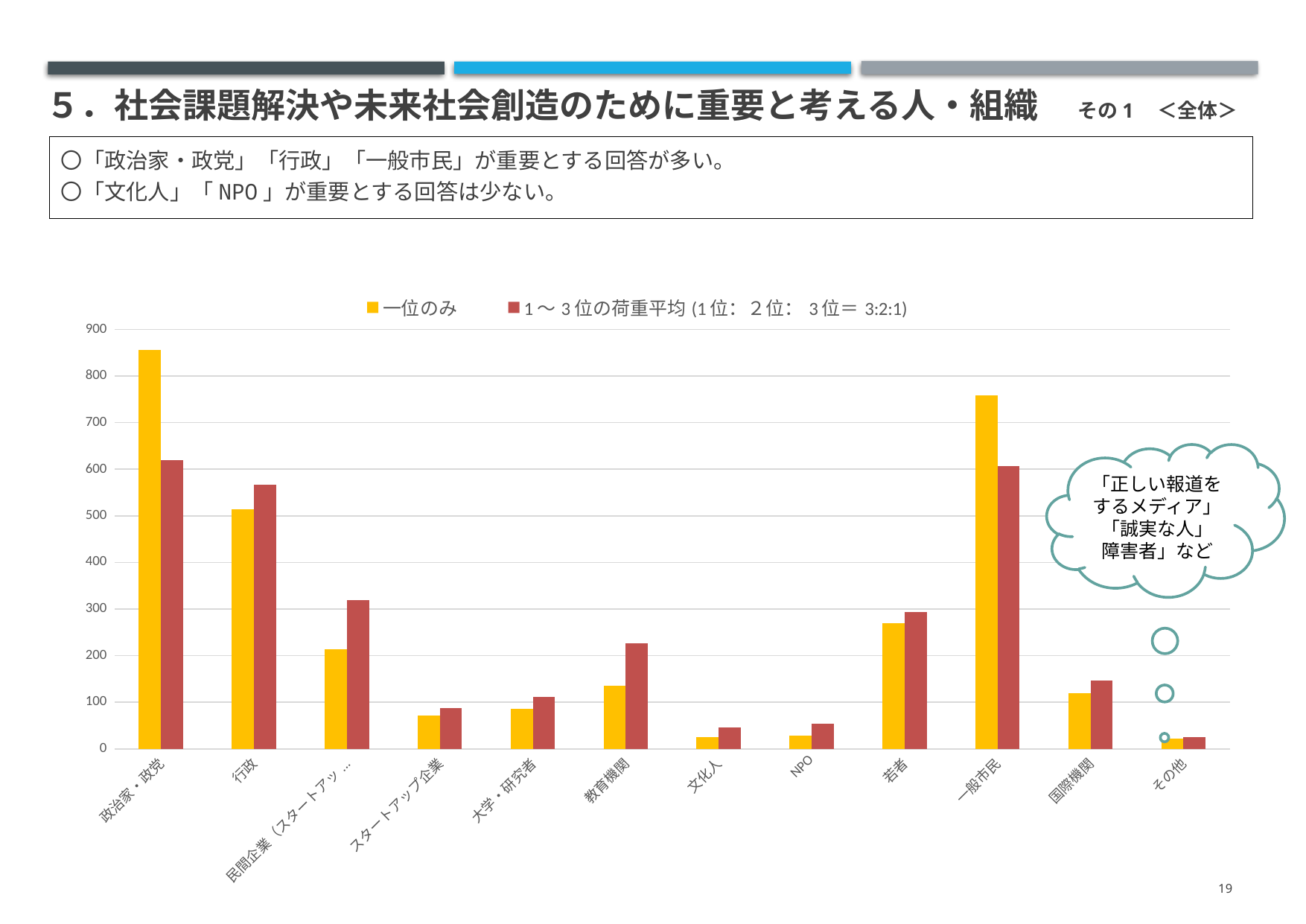
What kind of chart is shown on the slide? bar chart How many categories are shown on the x axis of the chart? 12 Is the 1～3位の荷重平均 value for 行政 greater or less than 500? greater Which category has the highest value for the 一位のみ series? 政治家・政党 Is the 一位のみ value for 一般市民 greater or less than 700? greater Is the 1～3位の荷重平均 value for 教育機関 greater or less than 300? less For 行政, which series has the larger value: 一位のみ or 1～3位の荷重平均? 1～3位の荷重平均 Which colour represents the 一位のみ series in the chart? yellow How many series does the chart legend list? 2 For 政治家・政党, which series has the larger value: 一位のみ or 1～3位の荷重平均? 一位のみ